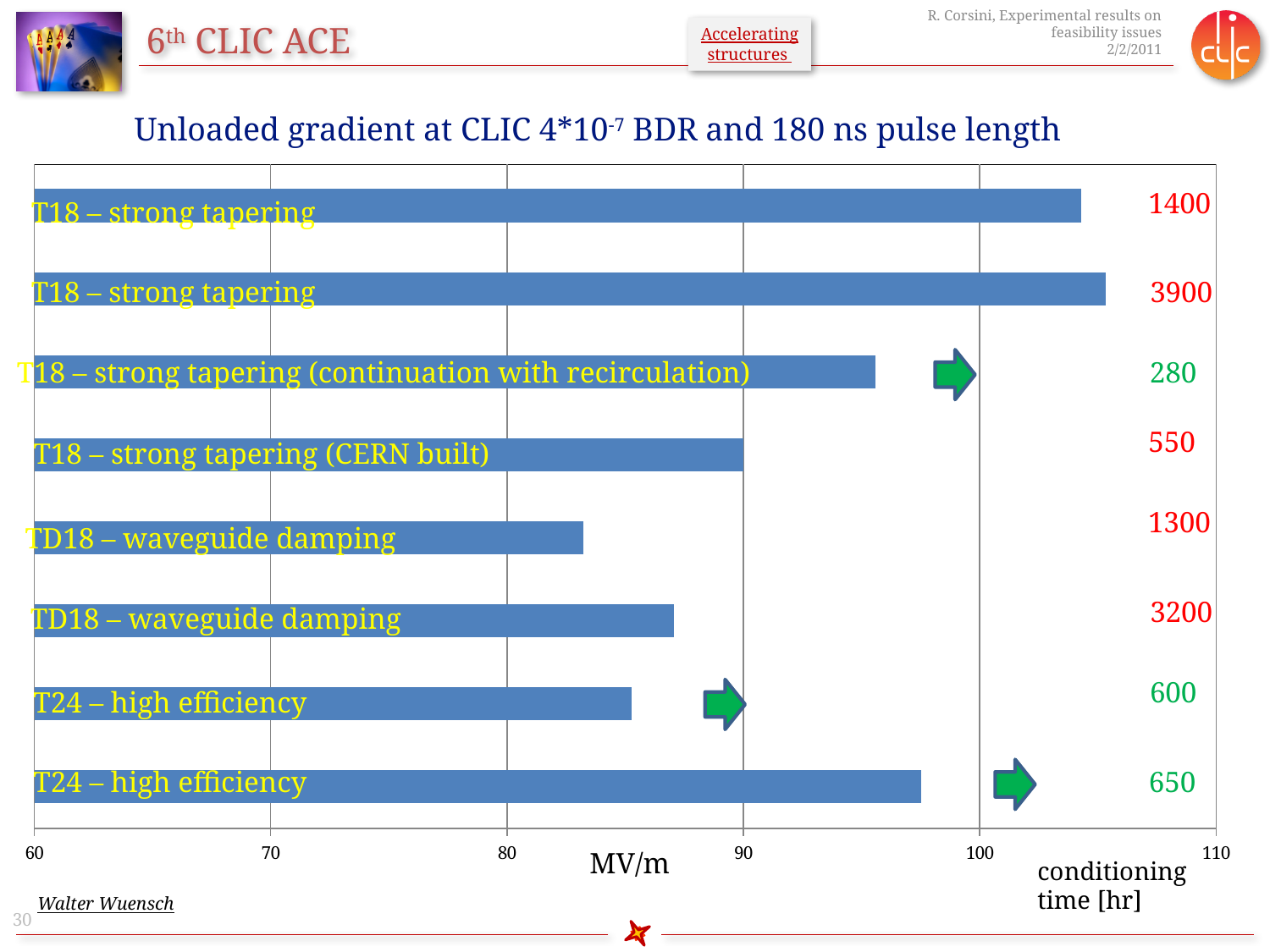
What is the difference between the conditioning times of the two T24 – high efficiency entries? 50 What conditioning time [hr] is listed for T18 – strong tapering (CERN built)? 550 What kind of chart is shown on the slide? bar chart What conditioning time [hr] is listed for T18 – strong tapering (continuation with recirculation)? 280 Which bar is shorter: the bottom T24 – high efficiency bar or the T18 – strong tapering (CERN built) bar? T18 – strong tapering (CERN built) Is the unloaded gradient for T18 – strong tapering (continuation with recirculation) greater or less than 100 MV/m? less What unit is shown on the x axis of the chart? MV/m Is the unloaded gradient for the bottom T24 – high efficiency bar greater or less than 90 MV/m? greater What is the title of the chart? Unloaded gradient at CLIC 4*10-7 BDR and 180 ns pulse length How many bars are plotted in the chart? 8 Which structure has the highest conditioning time listed, and what is it? T18 – strong tapering, 3900 Which structure has the lowest conditioning time listed? T18 – strong tapering (continuation with recirculation)